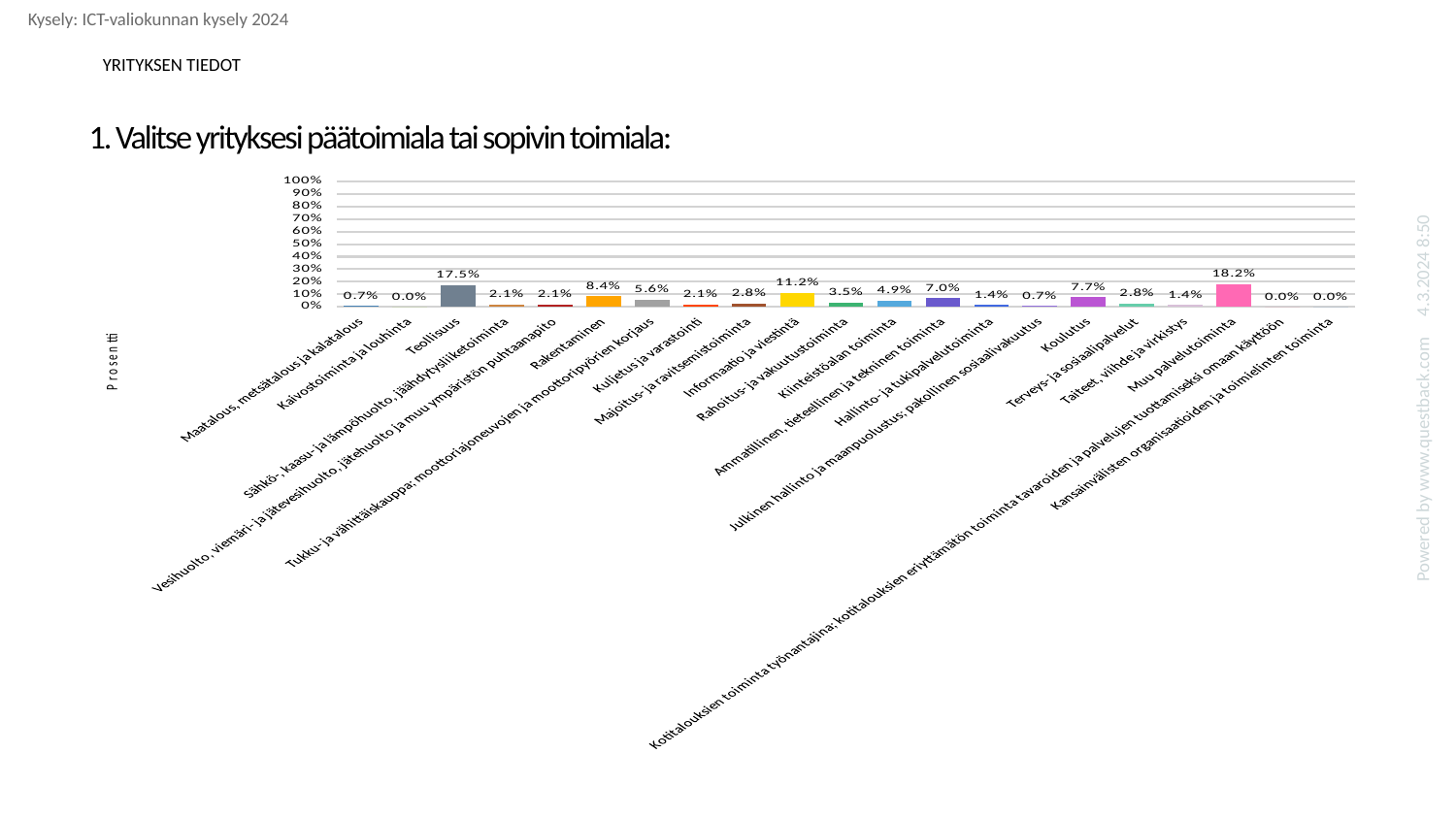
What kind of chart is shown on the slide? bar chart What is the difference between the values for Muu palvelutoiminta and Teollisuus? 0.7% What is the value for Rakentaminen? 8.4% What is the label of the y axis? Prosentti What is the value for Koulutus? 7.7% Which category has the highest value? Muu palvelutoiminta Which is larger, the value for Rakentaminen or the value for Koulutus? Rakentaminen How many categories have a value of 0.0%? 3 How many categories are shown on the x axis? 21 What is the value for Informaatio ja viestintä? 11.2% Which is larger, the value for Kiinteistöalan toiminta or the value for Rahoitus- ja vakuutustoiminta? Kiinteistöalan toiminta What is the value for Teollisuus? 17.5%